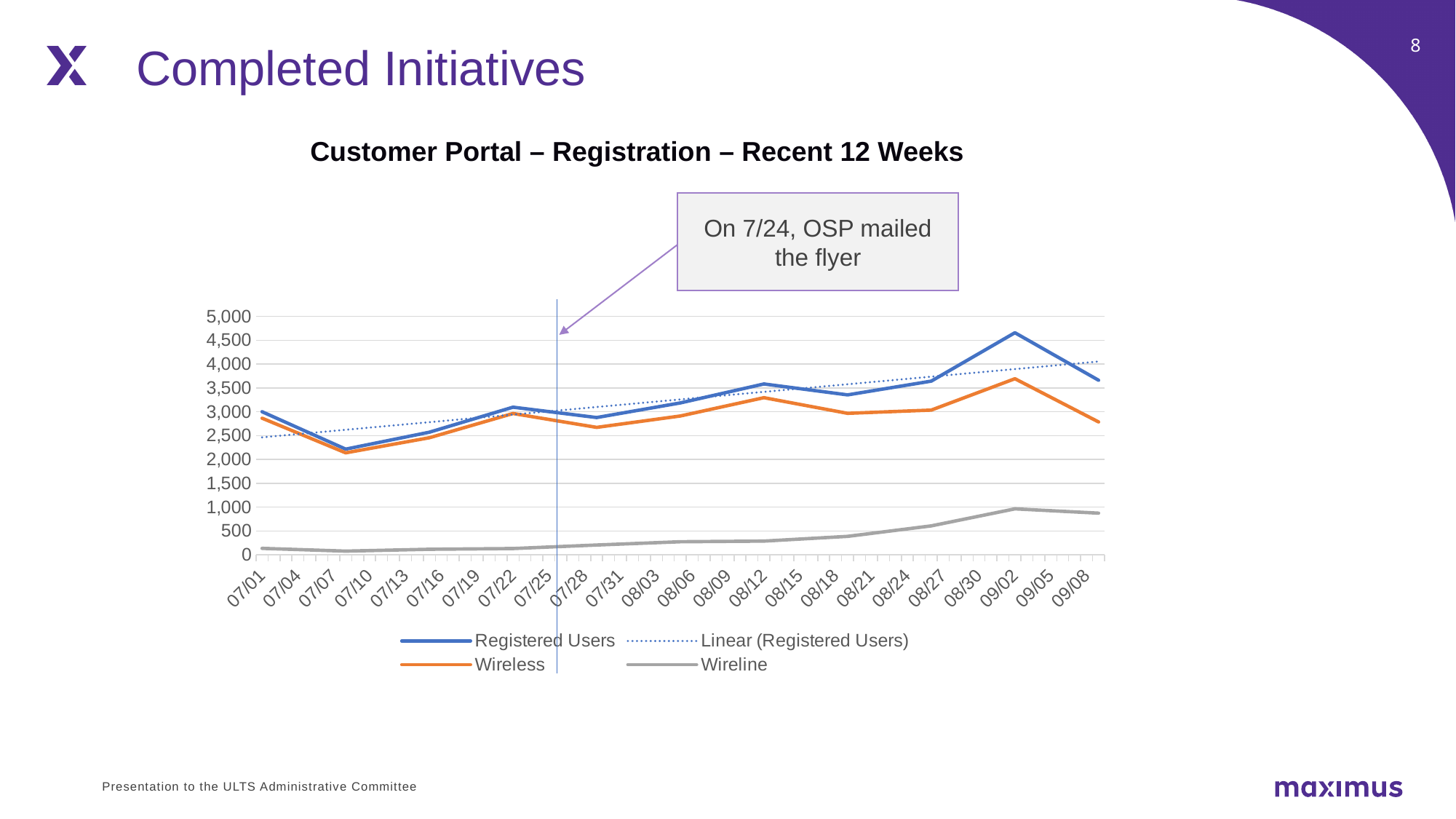
Is the value for Wireline at 07/01 greater or less than 500? less What is the title of the chart? Customer Portal – Registration – Recent 12 Weeks What does the annotation box above the chart say? On 7/24, OSP mailed the flyer Is the value for Registered Users at 09/02 greater or less than 4,500? greater On which date does the Registered Users series reach its highest value? 09/02 Is the value for Wireless at 09/02 greater or less than 3,500? greater What kind of chart is shown on the slide? line chart Does the Wireline series generally rise or fall from 07/01 to 09/02? rise How many series does the legend list? 4 At 09/02, which is larger: Registered Users or Wireline? Registered Users